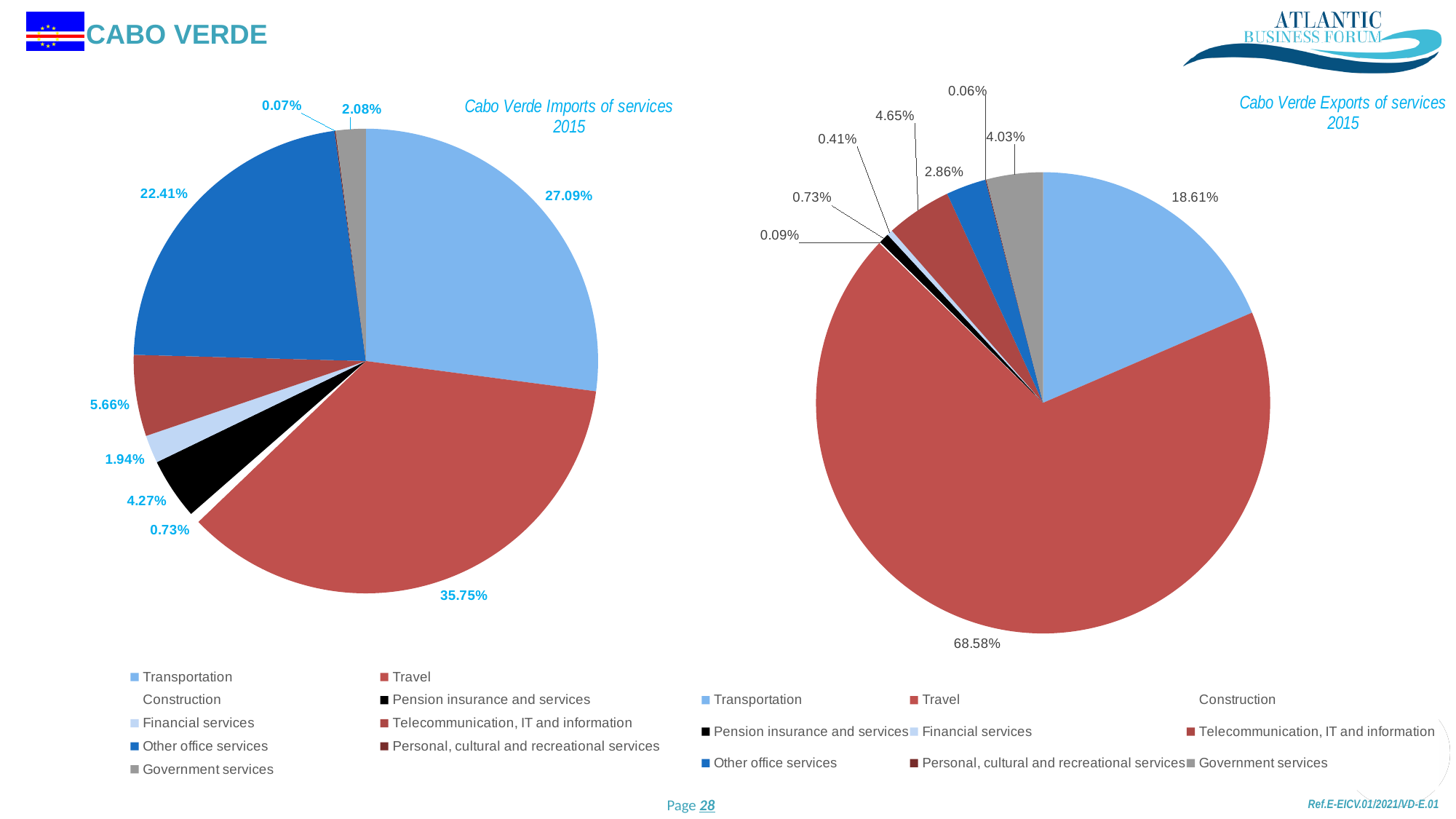
In the 'Cabo Verde Exports of services 2015' chart, which is larger: Telecommunication, IT and information or Other office services? Telecommunication, IT and information In the 'Cabo Verde Imports of services 2015' chart, which category has the smallest share? Personal, cultural and recreational services In the 'Cabo Verde Exports of services 2015' chart, what share does Government services have? 4.03% In the 'Cabo Verde Exports of services 2015' chart, what share does Transportation have? 18.61% In the 'Cabo Verde Imports of services 2015' chart, which category has the largest share? Travel In the 'Cabo Verde Exports of services 2015' chart, what share does Travel have? 68.58% How many categories does the legend of the 'Cabo Verde Imports of services 2015' chart list? 9 What type of chart is used for 'Cabo Verde Exports of services 2015'? Pie chart In the 'Cabo Verde Exports of services 2015' chart, which category has the smallest share? Personal, cultural and recreational services In the 'Cabo Verde Imports of services 2015' chart, what share does Travel have? 35.75% In the 'Cabo Verde Imports of services 2015' chart, what share does Other office services have? 22.41% In the 'Cabo Verde Imports of services 2015' chart, what is the difference between the Travel share and the Transportation share? 8.66%